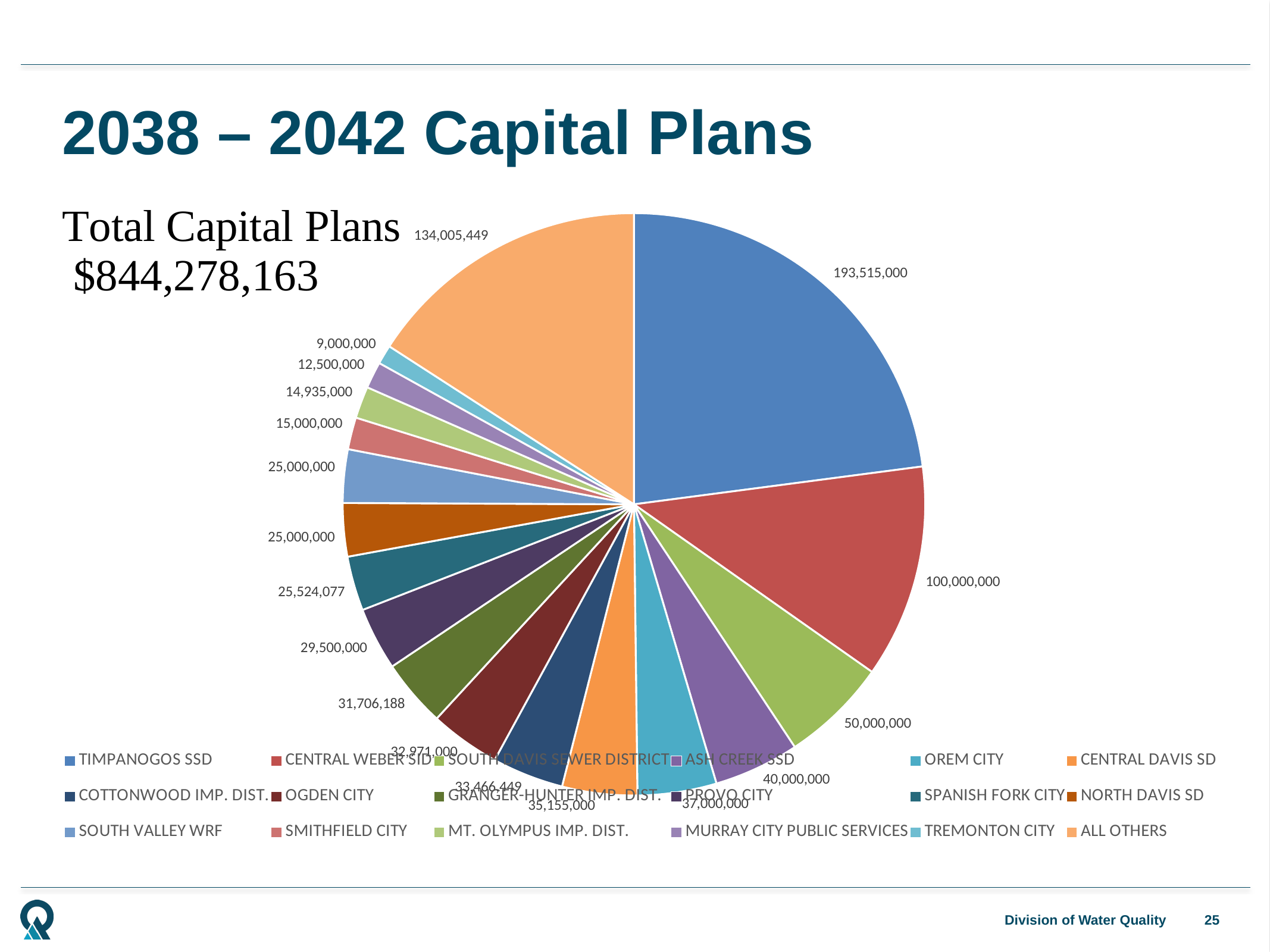
What is the value shown for SPANISH FORK CITY? 25,524,077 What is the value shown for ASH CREEK SSD? 40,000,000 Which category has the largest slice of the pie chart? TIMPANOGOS SSD What is the value shown for SOUTH DAVIS SEWER DISTRICT? 50,000,000 What kind of chart is shown on the slide? pie chart What total capital plans amount is stated on the slide? $844,278,163 What is the value shown for CENTRAL WEBER SID? 100,000,000 Which category has the smallest slice of the pie chart? TREMONTON CITY What is the value shown for ALL OTHERS? 134,005,449 Which is larger, the value for CENTRAL WEBER SID or the value for ALL OTHERS? ALL OTHERS How many slices does the pie chart have? 18 What is the difference between the values for TIMPANOGOS SSD and CENTRAL WEBER SID? 93,515,000